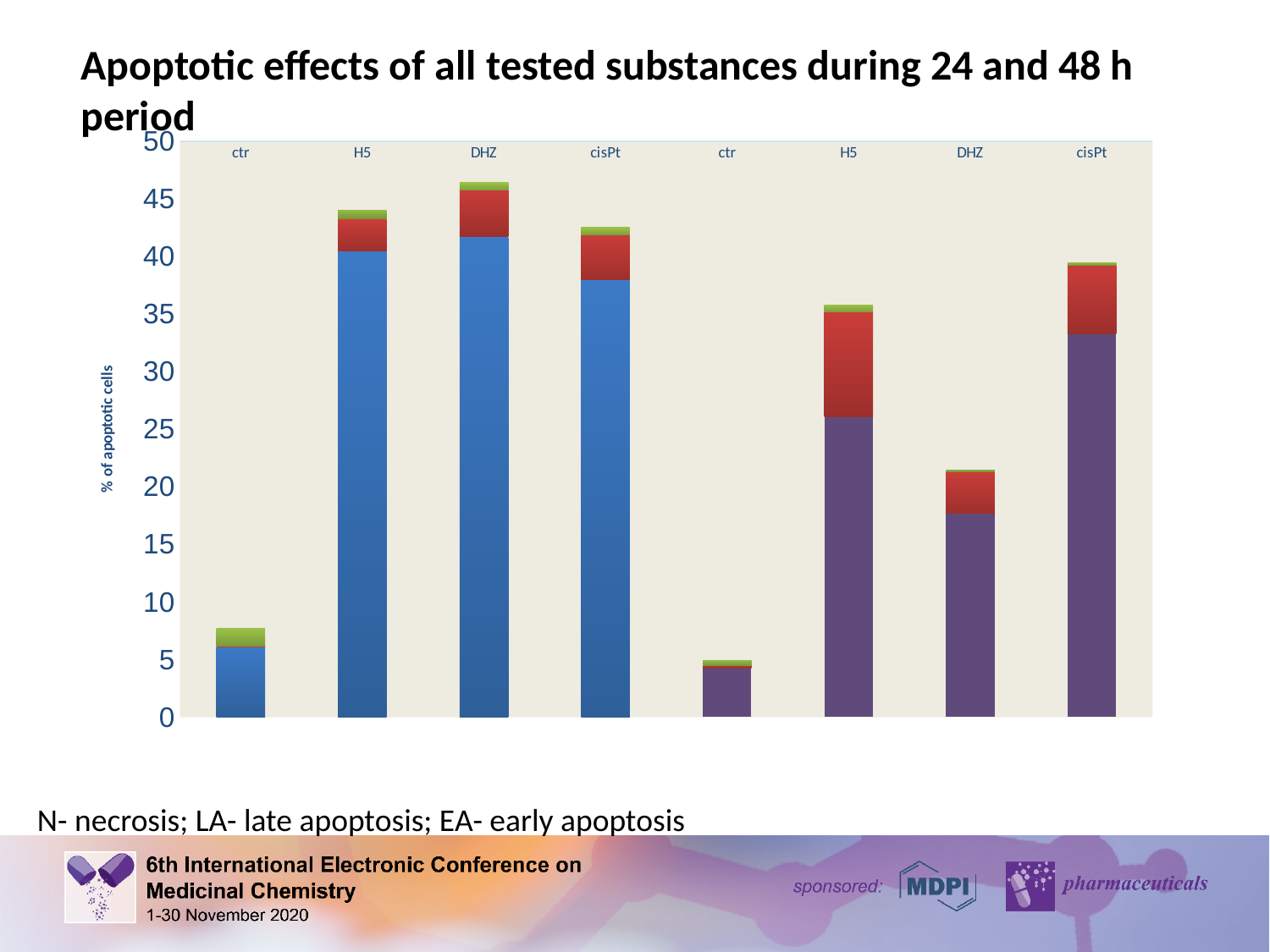
Is the total value for the second (purple) DHZ bar greater or less than 20? greater Is the total value for the second (purple) H5 bar greater or less than 30? greater What kind of chart is shown on the slide? stacked bar chart Which is larger, the first (blue) H5 bar or the second (purple) H5 bar? the first (blue) H5 bar Which bar is the tallest in the chart? DHZ (first group, blue) Is the total value for the first (blue) DHZ bar greater or less than 45? greater Which bar is the shortest in the chart? ctr (second group, purple) How many bars are plotted in the chart? 8 What is the label of the vertical axis? % of apoptotic cells What is the title of the chart on the slide? Apoptotic effects of all tested substances during 24 and 48 h period